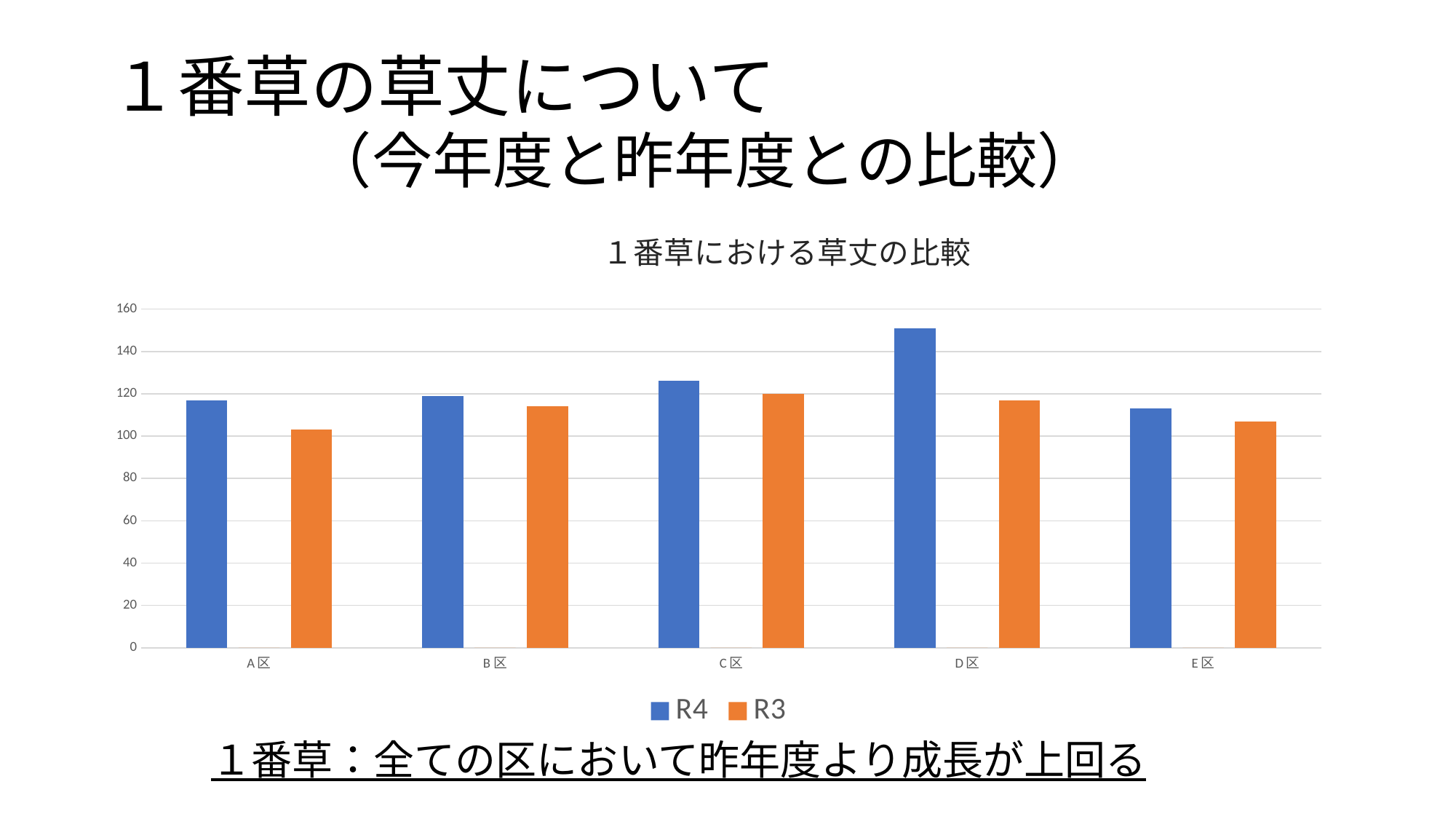
What is the title of the chart? １番草における草丈の比較 How many categories (区) are shown on the x axis? 5 Is the R3 value for D区 greater or less than 140? less Is the R3 value for E区 greater or less than 120? less For A区, which is larger, the R4 value or the R3 value? R4 Which category has the highest R4 value? D区 Is the R4 value for D区 greater or less than 140? greater How many series does the legend list? 2 What kind of chart is shown on the slide? bar chart Which series are listed in the legend? R4, R3 For D区, which is larger, the R4 value or the R3 value? R4